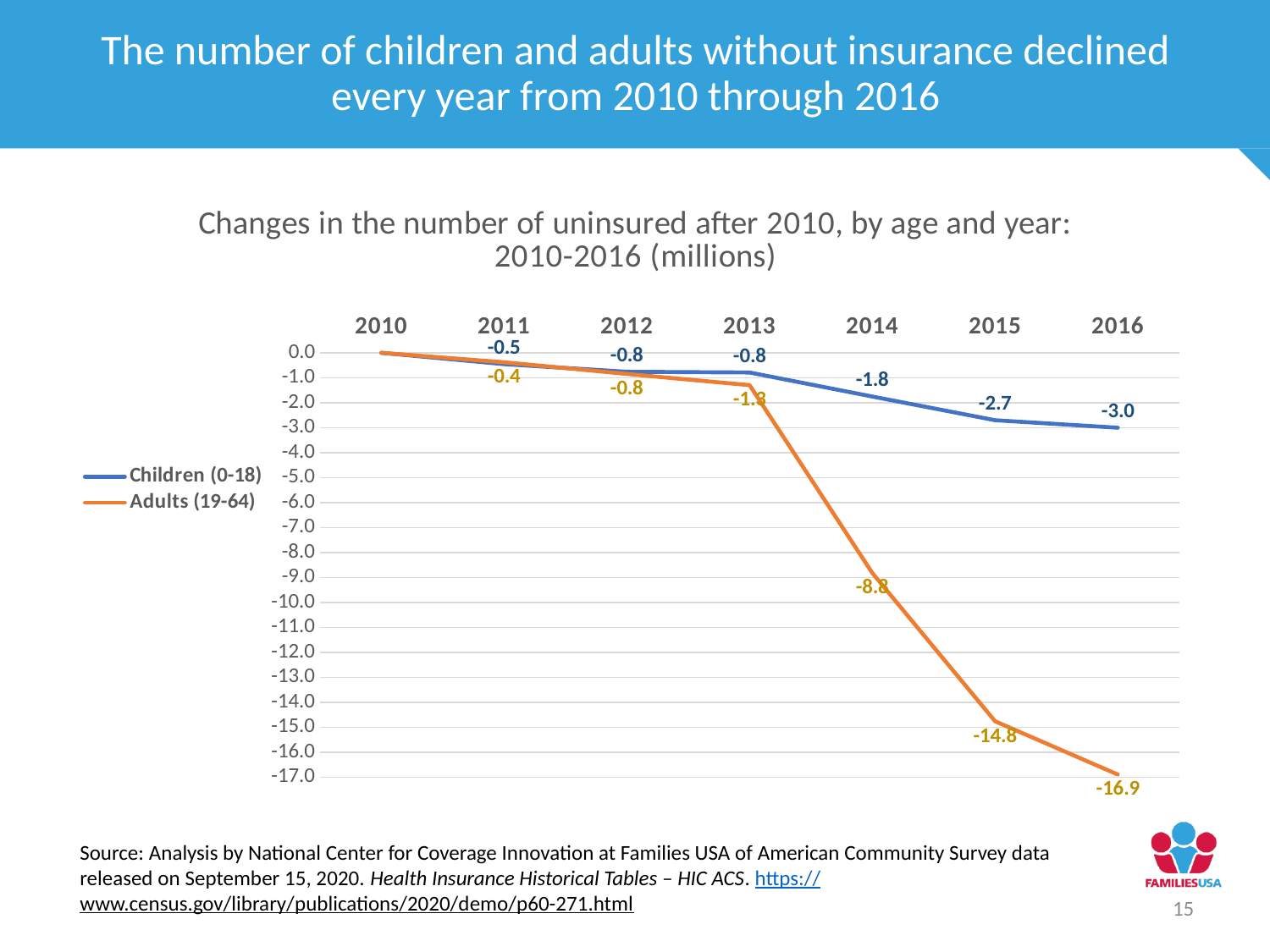
What is the value for Adults (19-64) in 2016? -16.9 What is the difference between the Children (0-18) value and the Adults (19-64) value in 2016? 13.9 What is the value for Adults (19-64) in 2015? -14.8 What kind of chart is shown on the slide? line chart What is the value for Children (0-18) in 2011? -0.5 What is the value for Children (0-18) in 2016? -3.0 How many years are plotted on the x axis? 7 Is the value for Adults (19-64) in 2014 greater or less than -5.0? less In 2015, which series has the lower value, Children (0-18) or Adults (19-64)? Adults (19-64) Do the values for Adults (19-64) rise or fall from 2010 to 2016? fall How many series does the legend list? 2 What is the value for Children (0-18) in 2014? -1.8